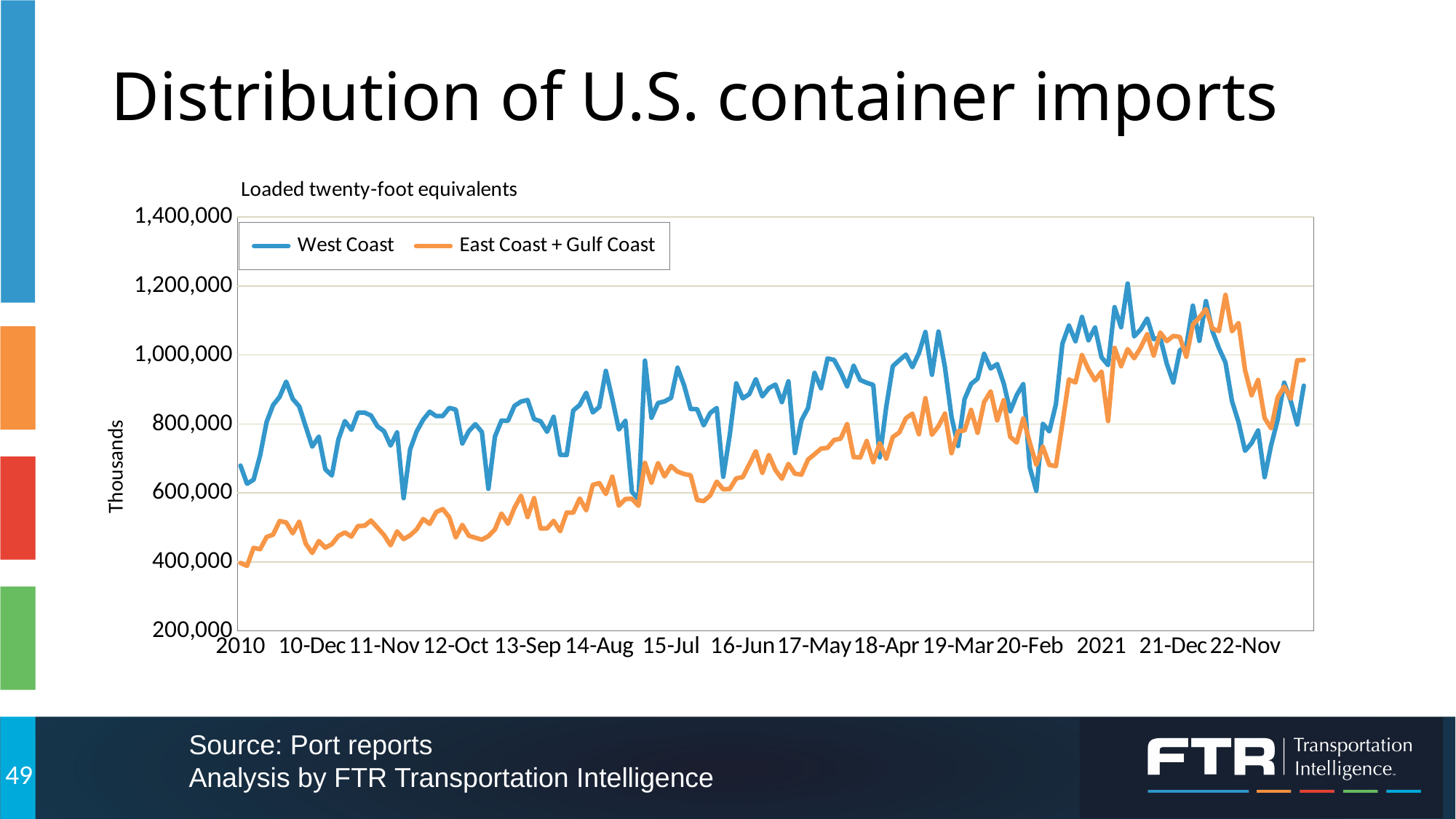
Does the East Coast + Gulf Coast line generally rise or fall from 2010 to 22-Nov? rise What kind of chart is shown on the slide? Line chart Is the East Coast + Gulf Coast value at the start of the chart (2010) greater or less than 600,000? less What are the two series named in the legend? West Coast; East Coast + Gulf Coast Is the lowest point of the East Coast + Gulf Coast line greater or less than 600,000? less Is the highest point of the West Coast line greater or less than 1,000,000? greater How many series does the legend list? 2 How many labels are shown along the x axis? 15 What unit label is shown on the vertical axis? Thousands At the start of the chart (2010), which series is higher, West Coast or East Coast + Gulf Coast? West Coast